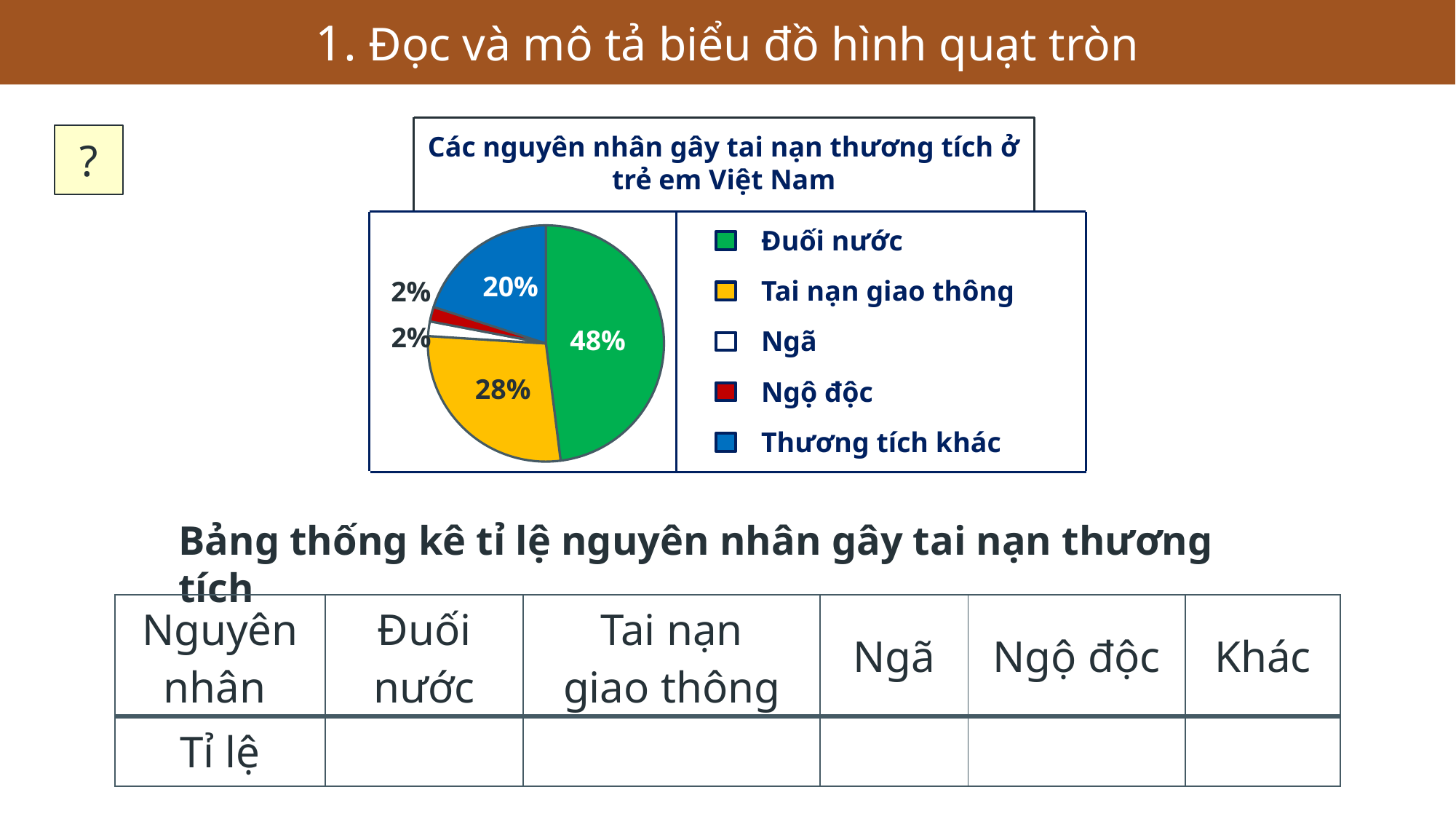
What percentage of the pie chart is Thương tích khác? 20% What percentage of the pie chart is Ngộ độc? 2% Which is larger, the share for Tai nạn giao thông or the share for Thương tích khác? Tai nạn giao thông Which cause has the largest share of the pie chart? Đuối nước How many categories does the legend of the pie chart list? 5 What colour is the Thương tích khác slice in the pie chart? blue What kind of chart is shown on the slide? pie chart What percentage of the pie chart is Ngã? 2% What percentage of the pie chart is Đuối nước? 48% What is the title of the pie chart? Các nguyên nhân gây tai nạn thương tích ở trẻ em Việt Nam What is the difference in percentage points between Đuối nước and Tai nạn giao thông? 20 What percentage of the pie chart is Tai nạn giao thông? 28%